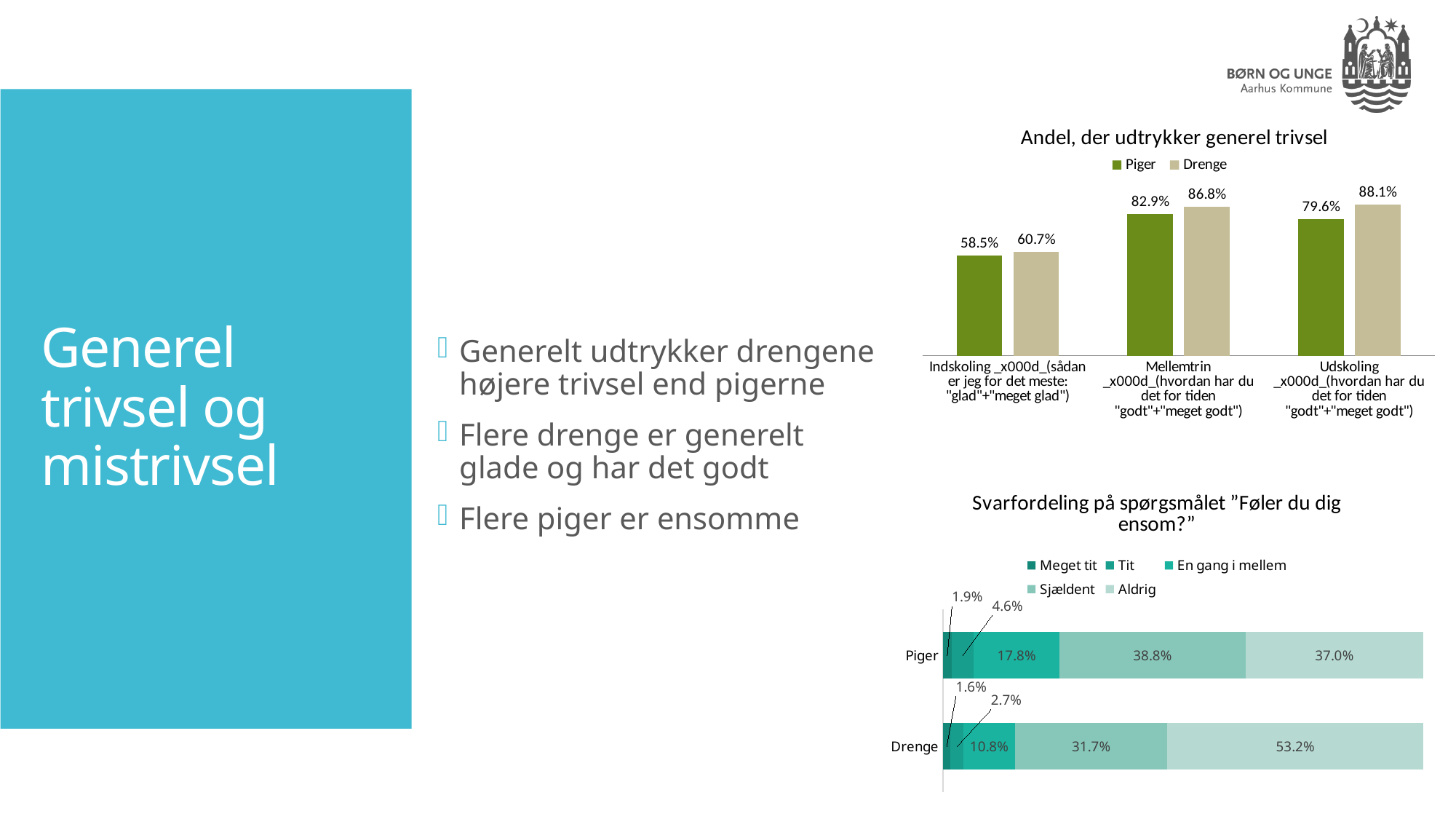
How many series does the legend of the chart 'Andel, der udtrykker generel trivsel' list? 2 In the chart 'Andel, der udtrykker generel trivsel', what is the value for Piger in Mellemtrin? 82.9% In the chart 'Svarfordeling på spørgsmålet "Føler du dig ensom?"', what is the value for En gang i mellem for Piger? 17.8% In the chart 'Andel, der udtrykker generel trivsel', which category has the lowest value for Piger? Indskoling In the chart 'Andel, der udtrykker generel trivsel', what is the difference between Drenge and Piger in Udskoling? 8.5% In the chart 'Svarfordeling på spørgsmålet "Føler du dig ensom?"', what is the difference between Sjældent for Piger and Sjældent for Drenge? 7.1% In the chart 'Andel, der udtrykker generel trivsel', which is larger in Indskoling, Piger or Drenge? Drenge In the chart 'Svarfordeling på spørgsmålet "Føler du dig ensom?"', what is the value for Aldrig for Drenge? 53.2% How many series does the legend of the chart 'Svarfordeling på spørgsmålet "Føler du dig ensom?"' list? 5 What kind of chart is 'Andel, der udtrykker generel trivsel'? Bar chart In the chart 'Svarfordeling på spørgsmålet "Føler du dig ensom?"', what is the total of the Drenge bar? 100.0% In the chart 'Andel, der udtrykker generel trivsel', what is the value for Drenge in Udskoling? 88.1%